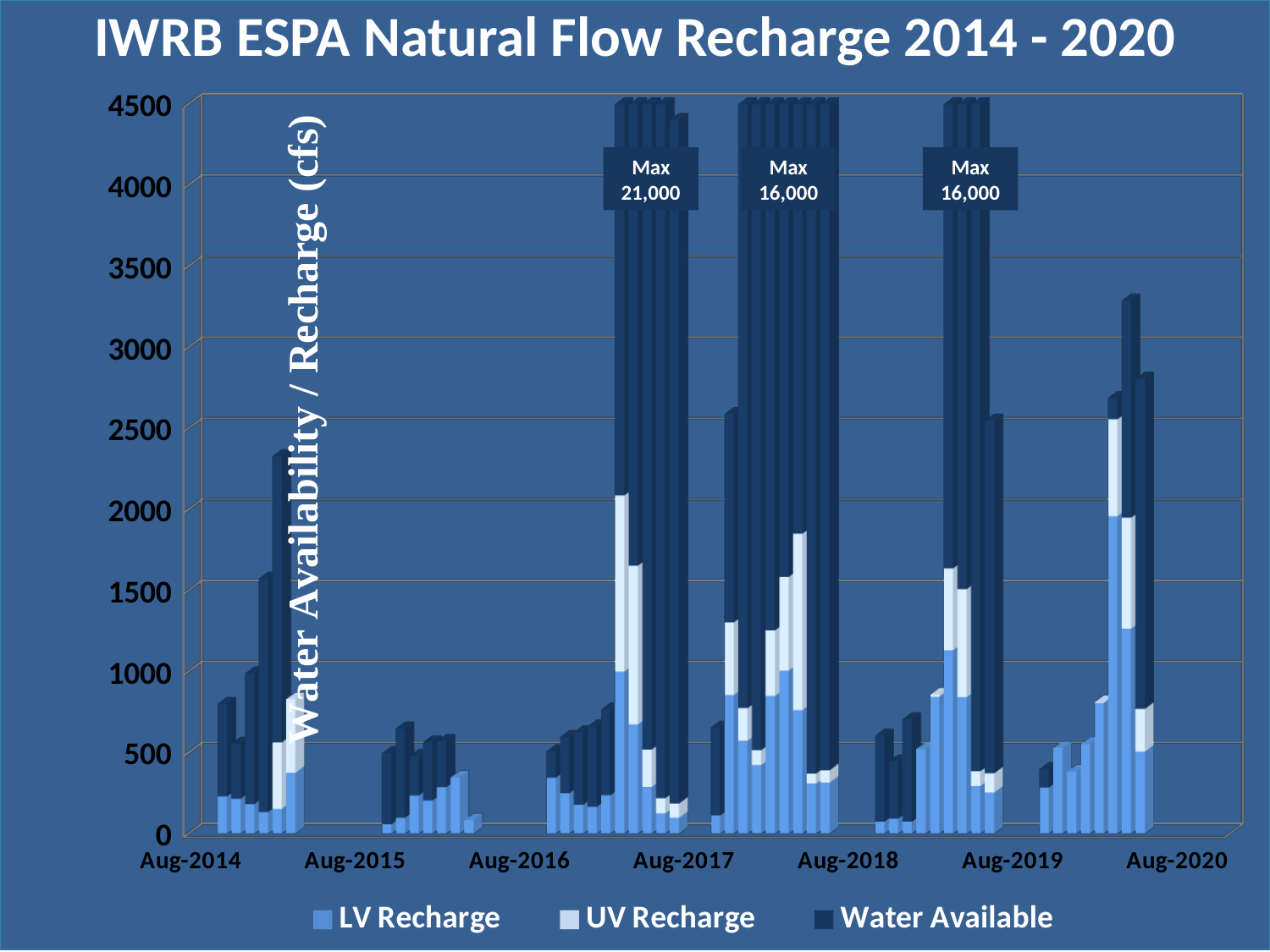
How many year labels are shown along the x axis? 7 What are the three series listed in the legend? LV Recharge, UV Recharge, Water Available What maximum value is annotated above the tall bars near Aug-2018? 16,000 What kind of chart is shown on the slide? Bar chart Is the tallest bar in the cluster just after Aug-2014 greater or less than 2000? greater How many series does the legend list? 3 What maximum value is annotated above the tall bars near Aug-2019? 16,000 Is the tallest bar in the cluster just before Aug-2020 greater or less than 3000? greater What maximum value is annotated above the tall bars near Aug-2017? 21,000 What is the highest tick value shown on the y axis? 4500 What is the title of the chart? IWRB ESPA Natural Flow Recharge 2014 - 2020 Is the tallest bar in the cluster just after Aug-2015 greater or less than 1000? less